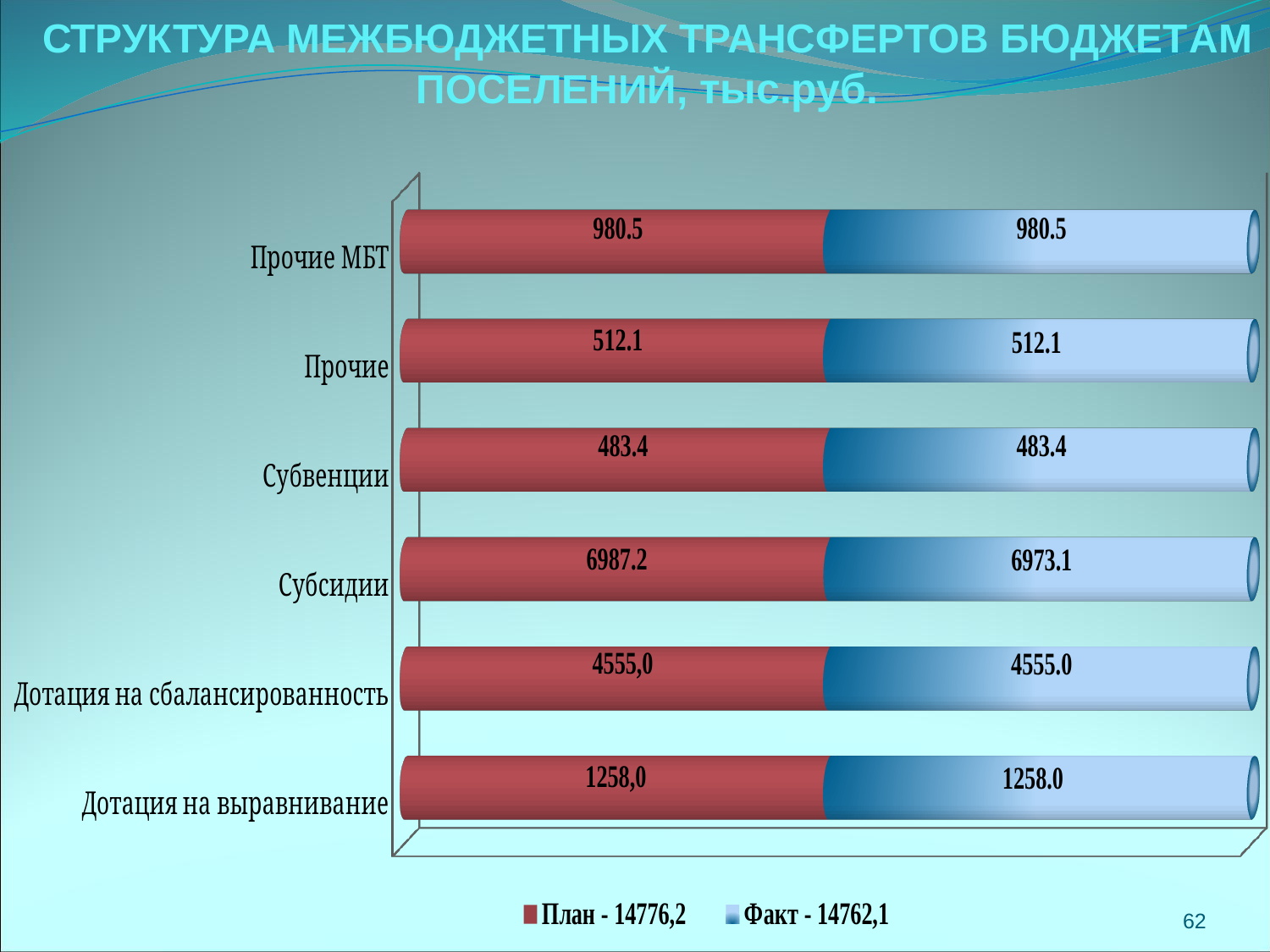
What is the difference between the План and Факт values for Субсидии? 14.1 What is the Факт value for Дотация на сбалансированность? 4555.0 Which category has the lowest Факт value? Субвенции Which is larger for Прочие: the План value or the Факт value? They are equal (512.1) What is the План value for Дотация на выравнивание? 1258,0 What kind of chart is shown on the slide? Stacked bar chart What is the Факт value for Прочие МБТ? 980.5 What is the Факт value for Субсидии? 6973.1 Which category has the highest План value? Субсидии How many series does the legend list? 2 What is the План value for Субсидии? 6987.2 How many categories are shown on the chart? 6